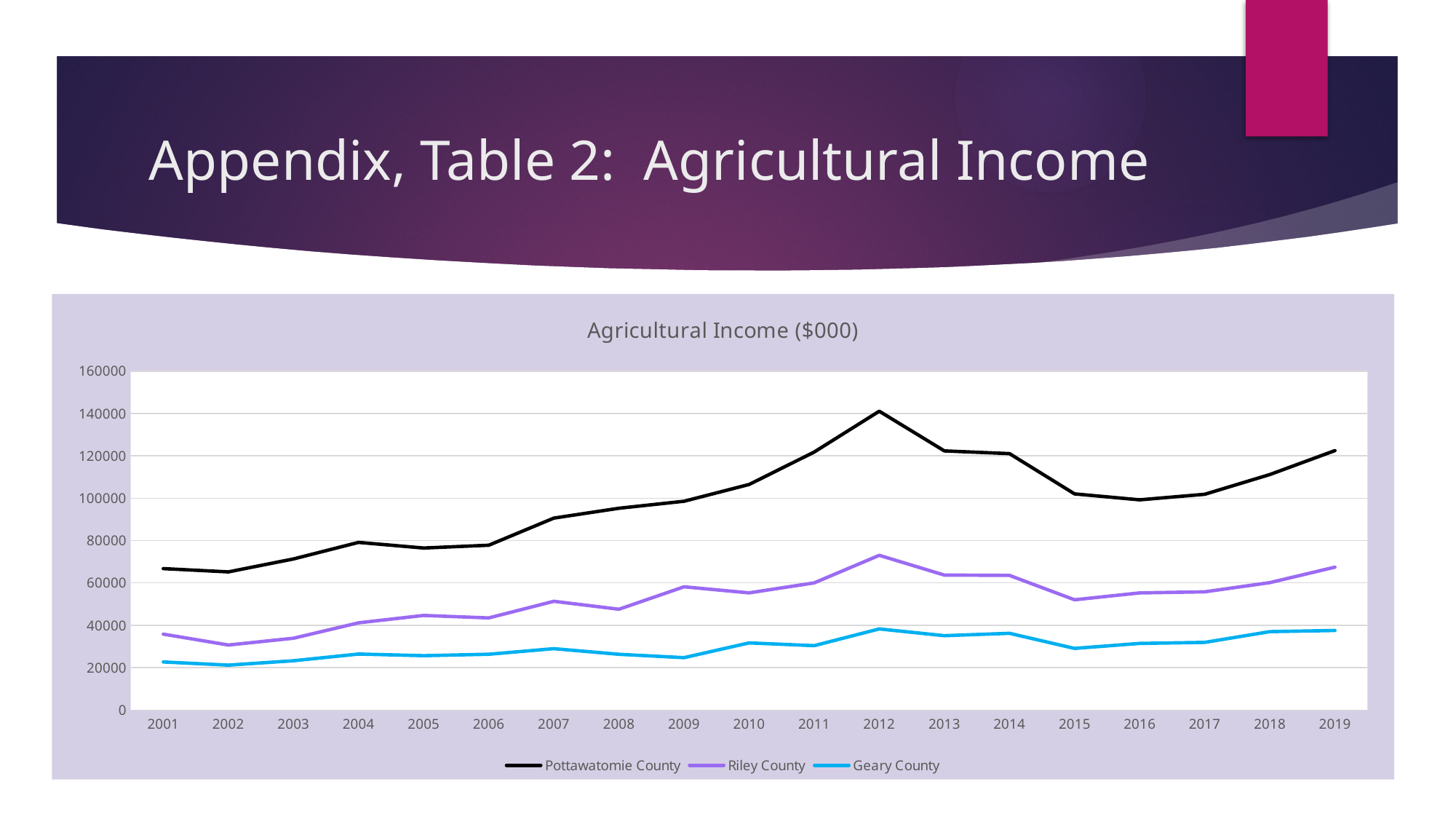
In which year does Pottawatomie County reach its highest agricultural income? 2012 Is the value for Pottawatomie County in 2001 greater or less than 80000? less Does Pottawatomie County's agricultural income rise or fall from 2012 to 2015? fall Which county has the higher agricultural income in 2019, Pottawatomie County or Riley County? Pottawatomie County Is the value for Geary County in 2009 greater or less than 40000? less How many years are plotted along the x axis? 19 How many series does the legend list? 3 In which year is Riley County's agricultural income lowest? 2002 Is the value for Pottawatomie County in 2012 greater or less than 120000? greater What is the title of the chart? Agricultural Income ($000) What kind of chart is shown on the slide? line chart In which year does Riley County reach its highest agricultural income? 2012